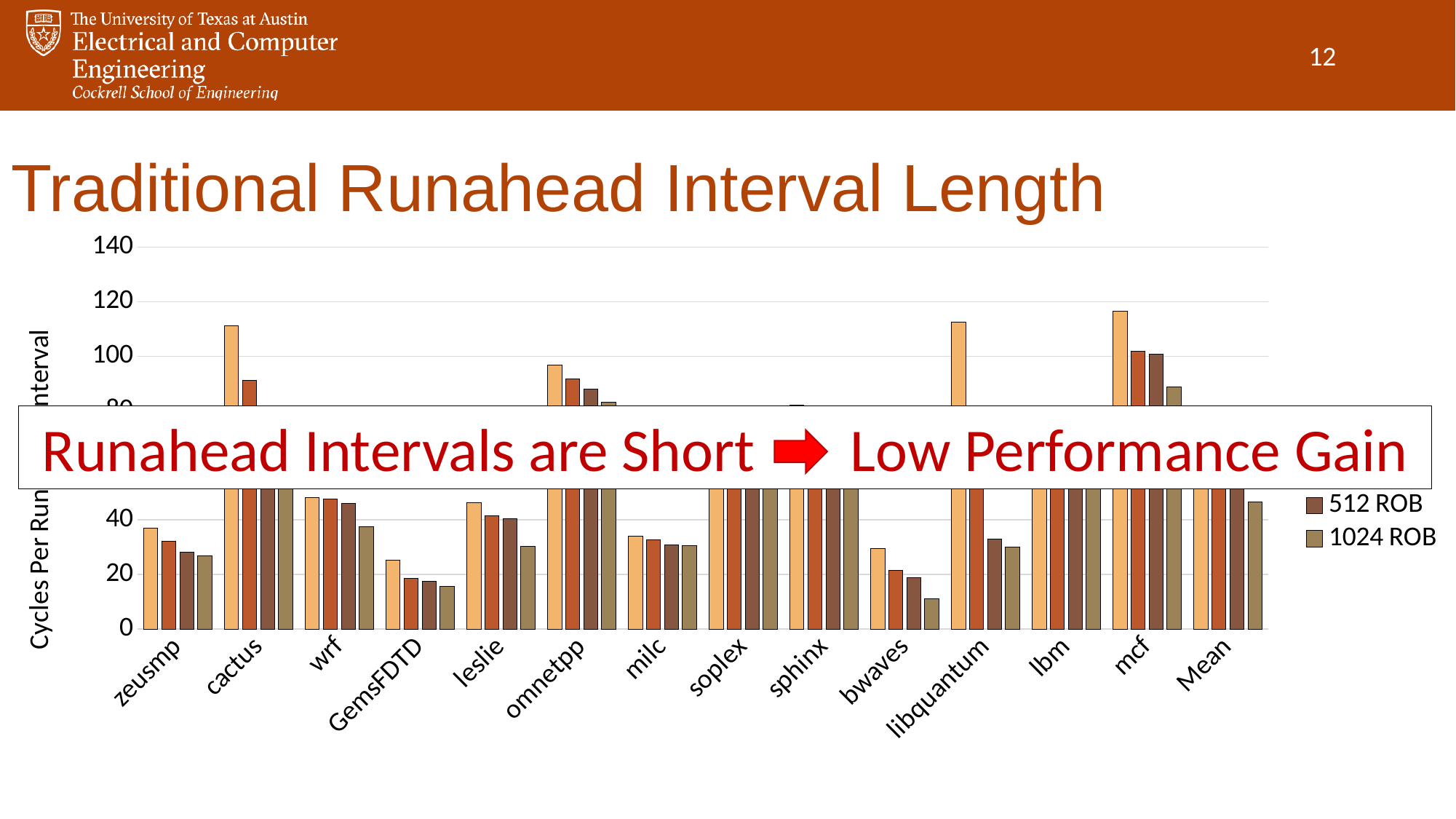
Is the value of the first (leftmost) bar for milc greater or less than 40? less Which category has the lowest 1024 ROB bar? bwaves Within the mcf category, do the bars rise or fall from left to right? fall Is the value of the first (leftmost) bar for zeusmp greater or less than 40? less Is the value of the 1024 ROB bar for bwaves greater or less than 20? less Which has a larger leftmost bar, cactus or zeusmp? cactus What is the highest tick value shown on the y axis? 140 How many categories are shown along the x axis of the chart? 14 What kind of chart is shown on the slide? bar chart What is the title of the chart's slide? Traditional Runahead Interval Length